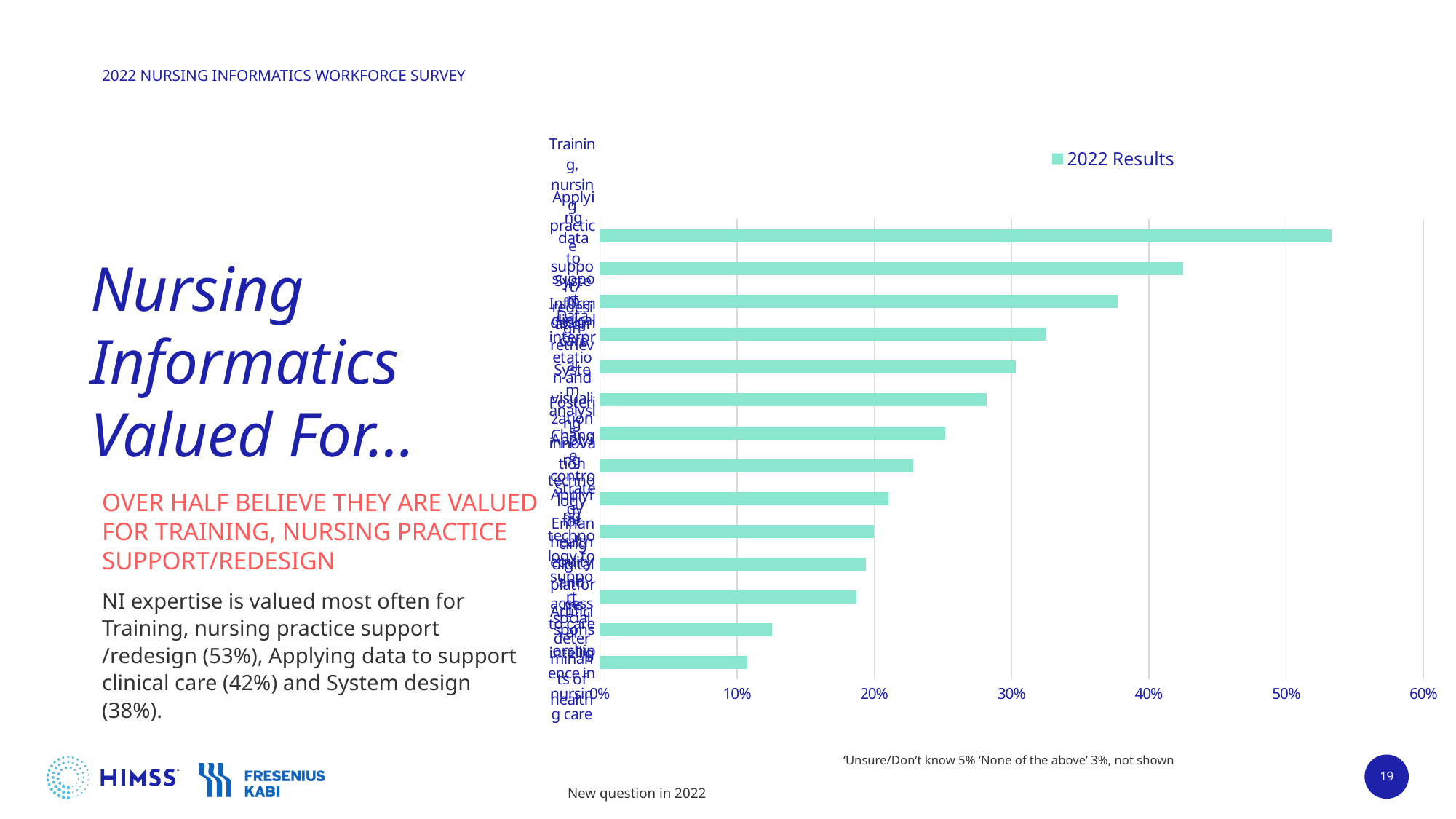
What is the highest tick value shown on the chart's horizontal axis? 60% How many series does the chart legend list? 1 Do the bar values increase or decrease going from the top of the chart to the bottom? decrease Is the value of the second bar from the bottom greater or less than 20%? less How many bars are plotted in the chart? 14 What is the name of the series shown in the chart legend? 2022 Results Is the value of the top (longest) bar greater or less than 50%? greater Which bar is the longest in the chart: the top bar or the bottom bar? the top bar Is the value of the bottom bar greater or less than 20%? less What kind of chart is shown on the slide? bar chart